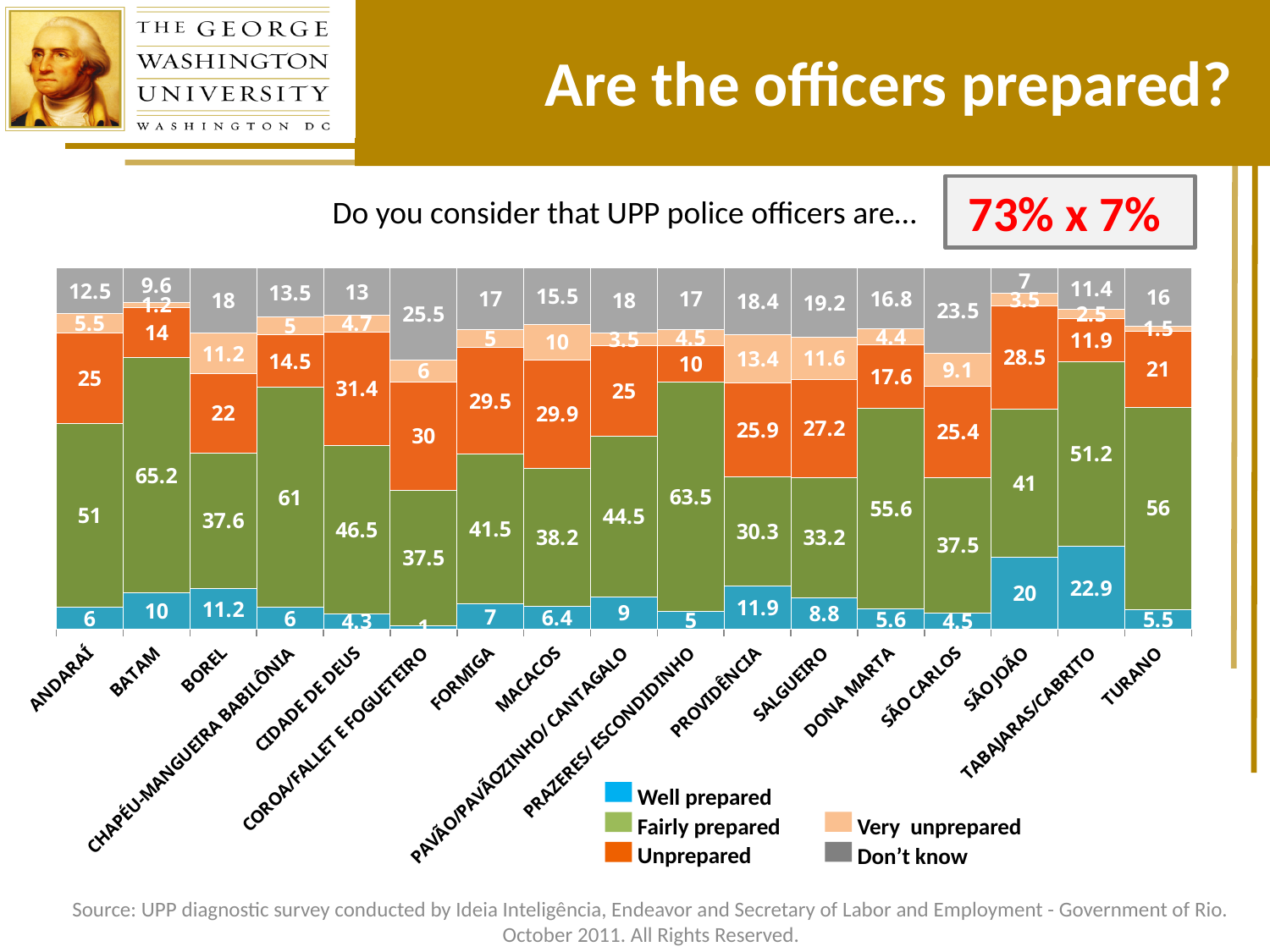
What is the 'Fairly prepared' value for BATAM? 65.2 What is the 'Unprepared' value for CIDADE DE DEUS? 31.4 How many series does the legend list? 5 Which community has the highest 'Well prepared' value? TABAJARAS/CABRITO What is the difference between the 'Fairly prepared' values for PRAZERES/ESCONDIDINHO and PROVIDÊNCIA? 33.2 What is the 'Don't know' value for SÃO CARLOS? 23.5 What is the total of the stacked bar for ANDARAÍ? 100 What kind of chart is shown on the slide? Stacked bar chart Which community has the lowest 'Well prepared' value? COROA/FALLET E FOGUETEIRO Which legend entry is shown in grey? Don't know Which is larger, the 'Unprepared' value for BOREL or for TURANO? BOREL How many communities (categories) are shown on the x axis? 17